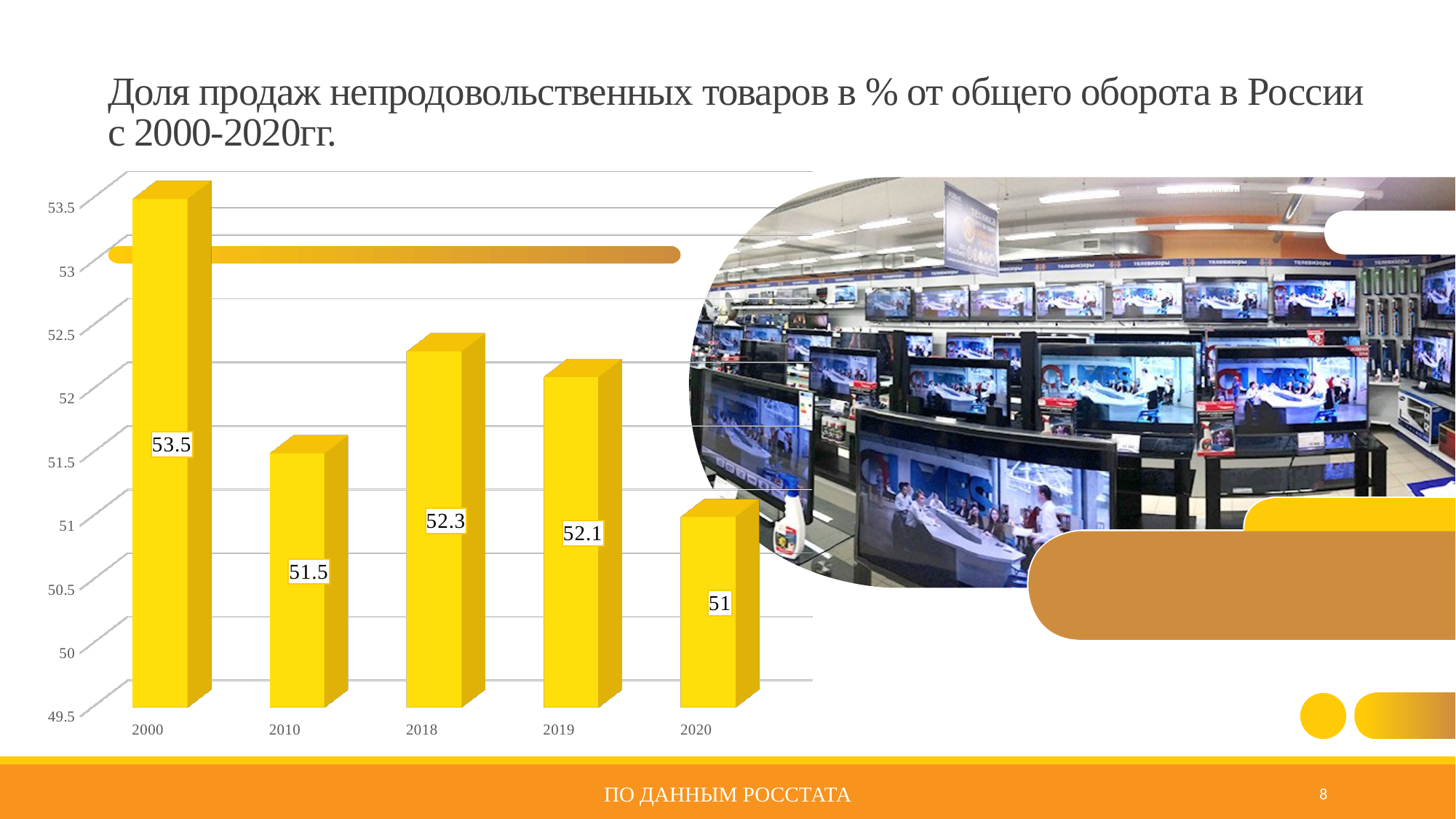
What kind of chart is shown on the slide? bar chart What is the value for 2020? 51 Which year has the lowest value? 2020 What is the difference between the values for 2000 and 2020? 2.5 Which is larger, the value for 2010 or the value for 2019? 2019 What is the value for 2010? 51.5 What is the value for 2000? 53.5 How many years are shown on the x axis? 5 Does the value rise or fall from 2018 to 2020? fall Which year has the highest value? 2000 What is the difference between the values for 2018 and 2019? 0.2 What is the value for 2018? 52.3